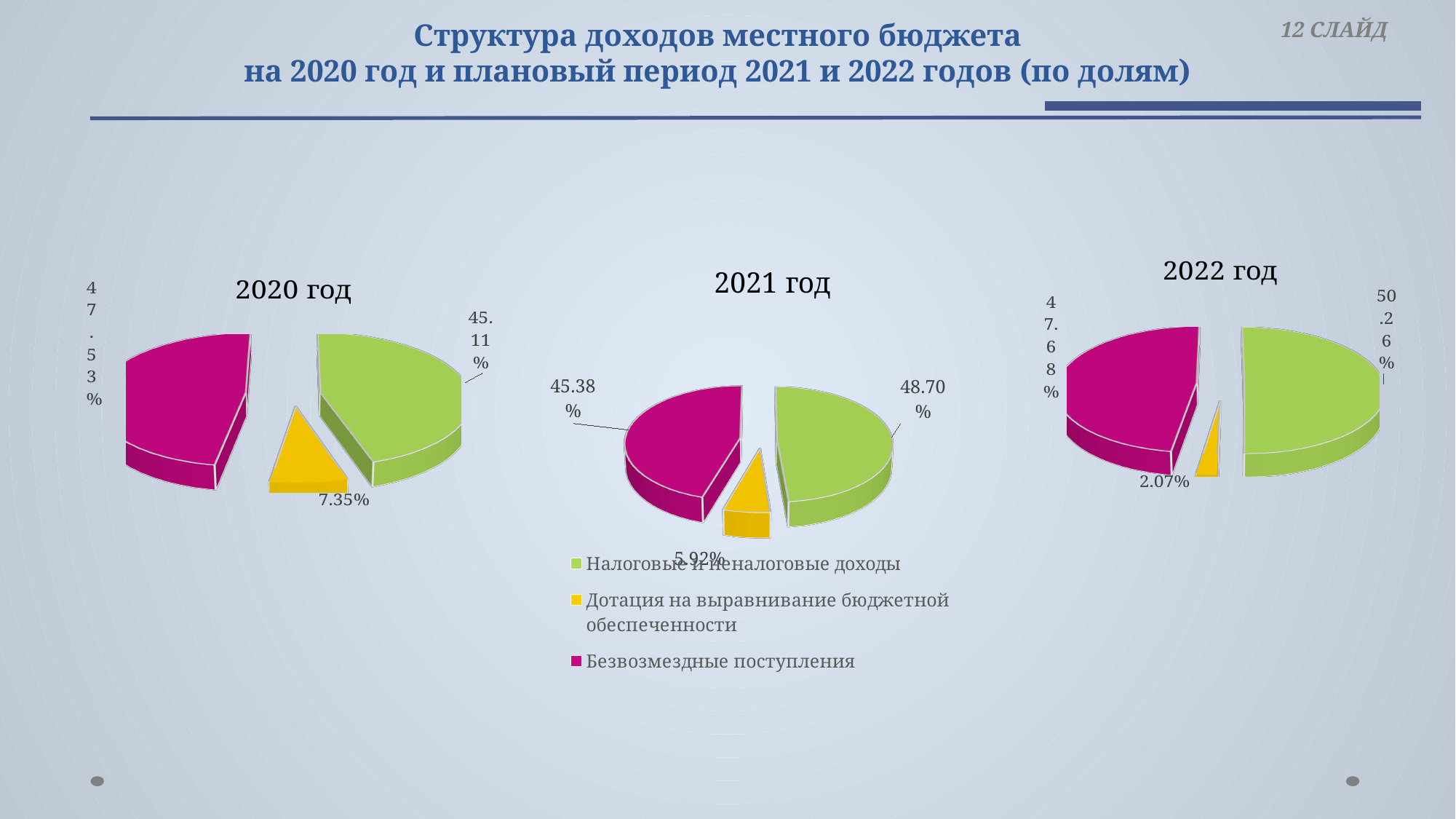
In the "2022 год" chart, which category has the smallest slice? Дотация на выравнивание бюджетной обеспеченности In the "2022 год" chart, what share is shown for Безвозмездные поступления? 47.68% In the "2020 год" chart, which is larger: the share of Безвозмездные поступления or the share of Налоговые и неналоговые доходы? Безвозмездные поступления What type of chart is used for the "2021 год" chart? Pie chart In the "2022 год" chart, which category has the largest slice? Налоговые и неналоговые доходы In the "2021 год" chart, what is the difference between the shares of Налоговые и неналоговые доходы and Безвозмездные поступления? 3.32% In the "2020 год" chart, what share is shown for Безвозмездные поступления? 47.53% In the "2021 год" chart, what share is shown for Дотация на выравнивание бюджетной обеспеченности? 5.92% In the "2021 год" chart, what share is shown for Налоговые и неналоговые доходы? 48.70% How many charts are shown on the slide? 3 In the "2020 год" chart, what share is shown for Дотация на выравнивание бюджетной обеспеченности? 7.35% In the "2020 год" chart, what share is shown for Налоговые и неналоговые доходы? 45.11%